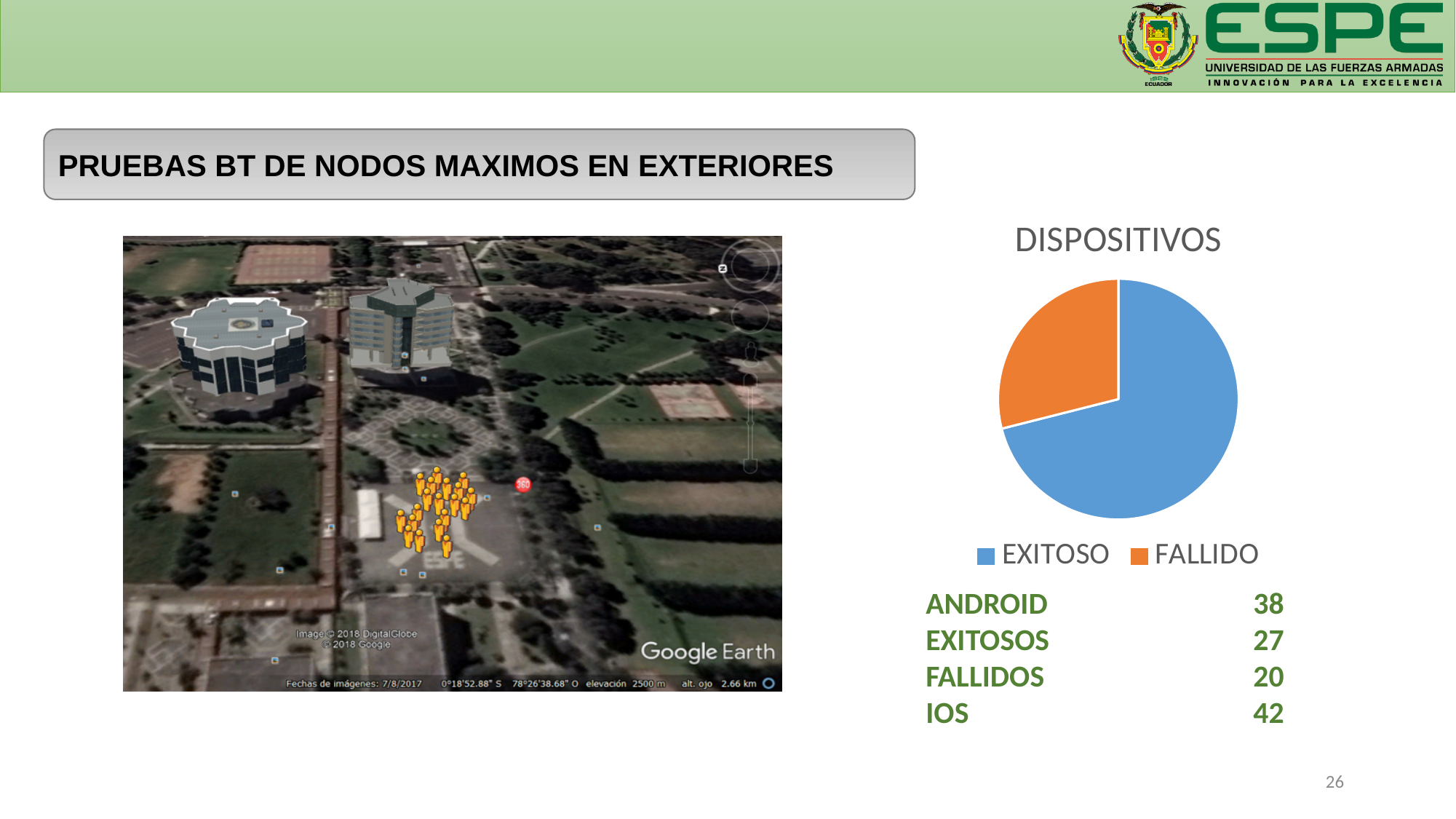
Which slice of the DISPOSITIVOS pie chart is the largest? EXITOSO What colour is the EXITOSO slice in the DISPOSITIVOS pie chart? blue How many slices does the DISPOSITIVOS pie chart have? 2 What is the title of the pie chart on the slide? DISPOSITIVOS Does the FALLIDO slice of the DISPOSITIVOS pie chart take up more or less than half of the pie? less In the DISPOSITIVOS pie chart, which is larger, EXITOSO or FALLIDO? EXITOSO What kind of chart is shown under the title DISPOSITIVOS? pie chart How many entries does the legend of the DISPOSITIVOS pie chart list? 2 Which slice of the DISPOSITIVOS pie chart is the smallest? FALLIDO Does the EXITOSO slice of the DISPOSITIVOS pie chart take up more or less than half of the pie? more